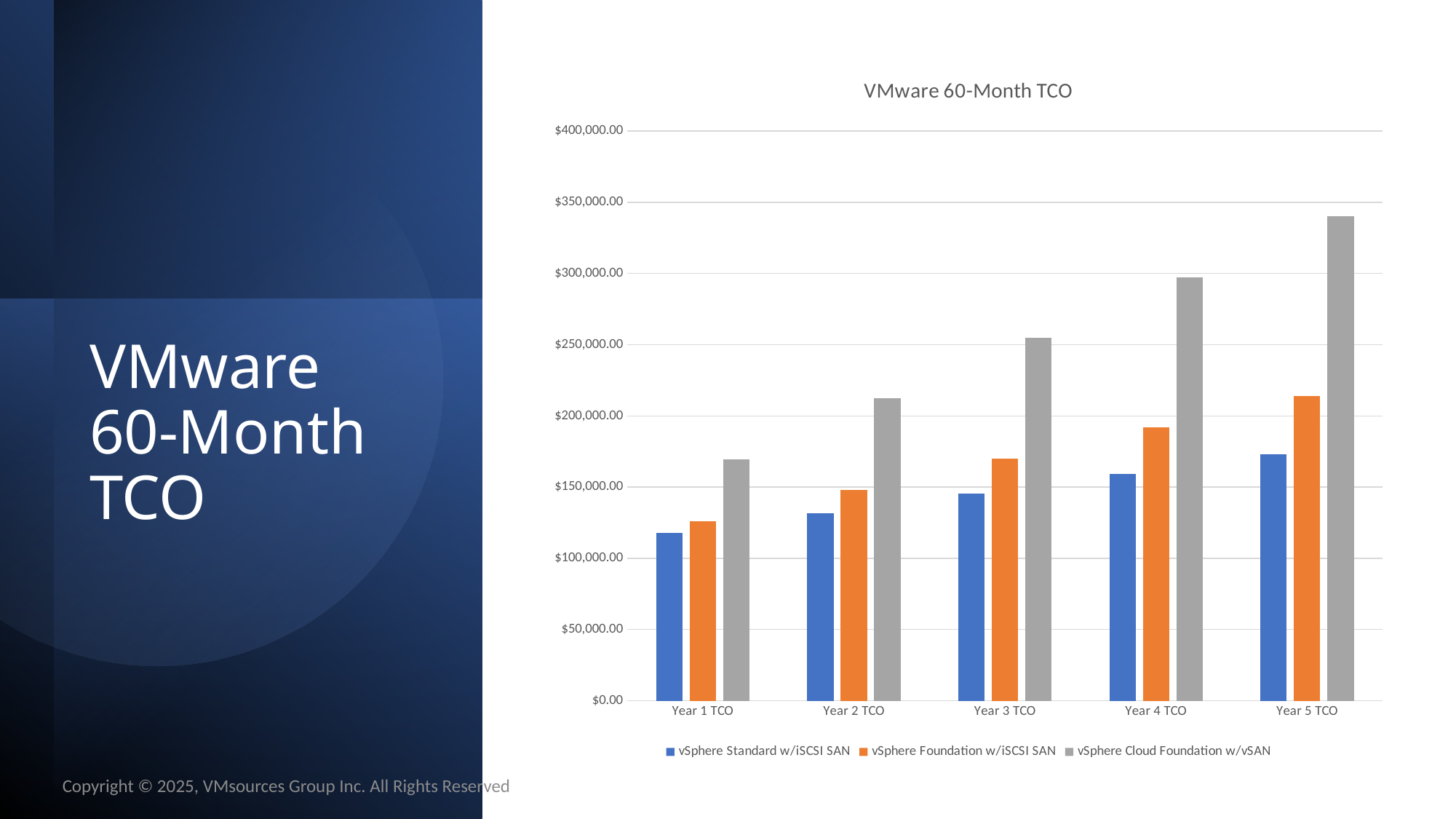
Do the values for vSphere Cloud Foundation w/vSAN rise or fall from Year 1 TCO to Year 5 TCO? rise Which series has the highest value in Year 5 TCO? vSphere Cloud Foundation w/vSAN Which series has the lowest value in Year 1 TCO? vSphere Standard w/iSCSI SAN How many series does the legend list? 3 Which is larger: vSphere Cloud Foundation w/vSAN in Year 3 TCO or vSphere Foundation w/iSCSI SAN in Year 5 TCO? vSphere Cloud Foundation w/vSAN in Year 3 TCO How many year categories are shown on the x axis? 5 Is the value for vSphere Standard w/iSCSI SAN in Year 1 TCO greater or less than $150,000.00? less Is the value for vSphere Cloud Foundation w/vSAN in Year 2 TCO greater or less than $200,000.00? greater Is the value for vSphere Cloud Foundation w/vSAN in Year 5 TCO greater or less than $300,000.00? greater What kind of chart is shown on the slide? bar chart What is the title of the chart? VMware 60-Month TCO